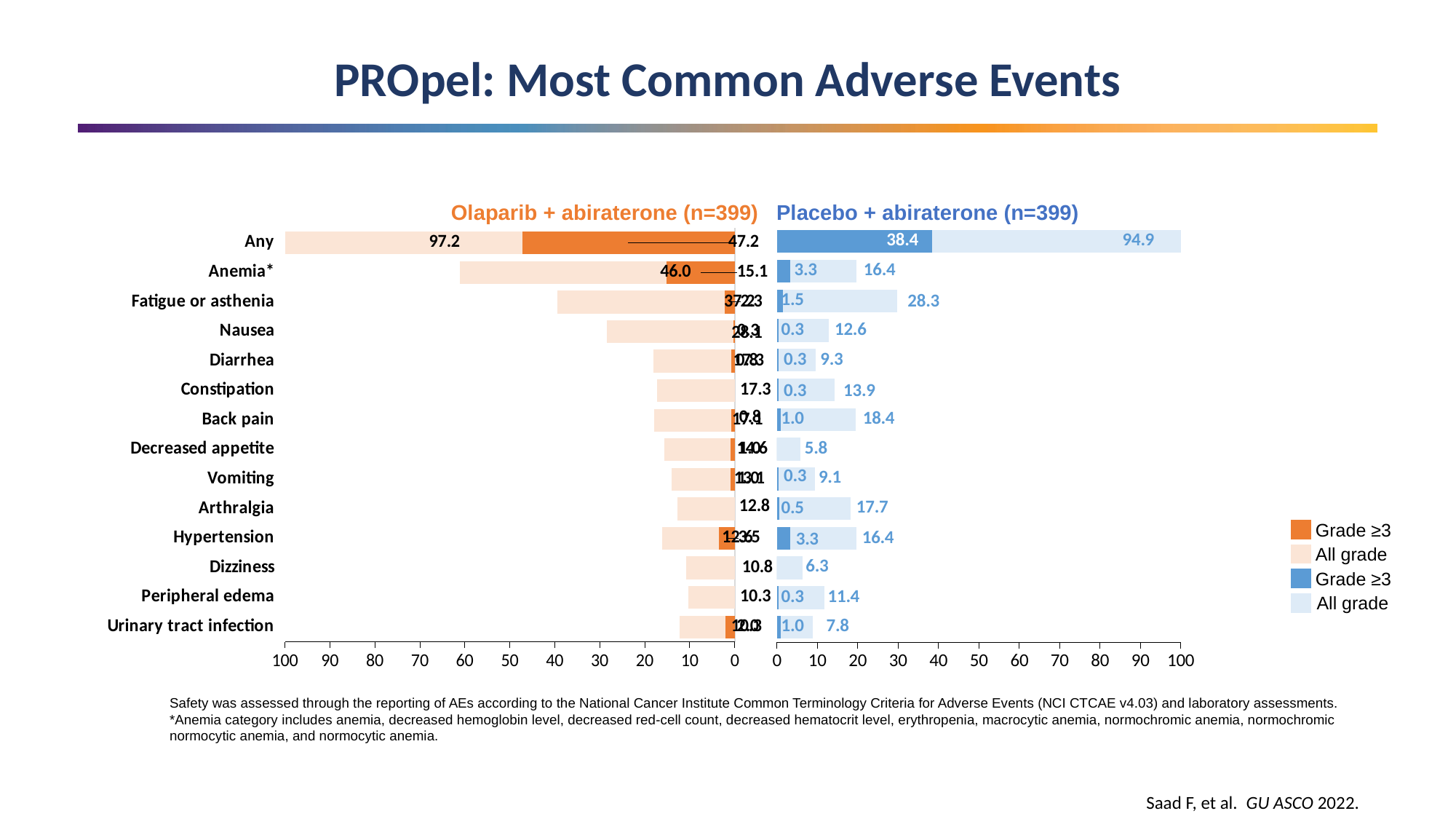
What is the Grade ≥3 value for Hypertension in the Placebo + abiraterone group? 3.3 How many adverse event categories are listed on the chart? 14 What is the all-grade value for Anemia* in the Olaparib + abiraterone group? 46.0 How many entries does the legend list? 4 Is the all-grade value for Nausea in the Olaparib + abiraterone group greater or less than 20? greater What type of chart is shown on the slide? Bar chart What is the Grade ≥3 value for Any adverse event in the Placebo + abiraterone group? 38.4 Which is larger: the all-grade value for Back pain or for Arthralgia in the Placebo + abiraterone group? Back pain What is the difference between the all-grade values for Any adverse event in the Olaparib + abiraterone group (97.2) and the Placebo + abiraterone group (94.9)? 2.3 What is the all-grade value for Any adverse event in the Olaparib + abiraterone group? 97.2 What is the all-grade value for Fatigue or asthenia in the Placebo + abiraterone group? 28.3 Which adverse event has the lowest all-grade value in the Placebo + abiraterone group? Decreased appetite